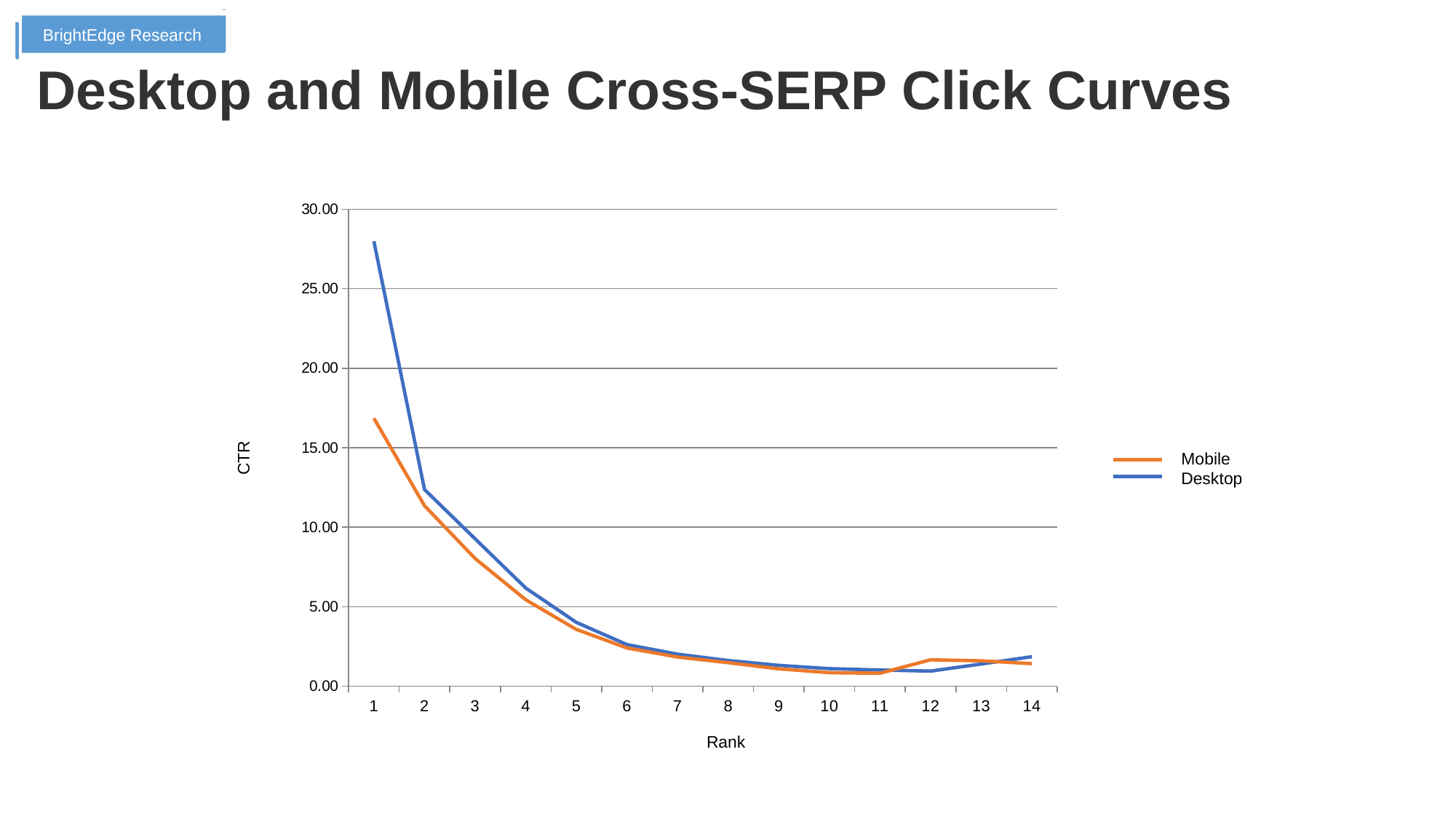
Is the Desktop CTR at rank 1 greater or less than 25.00? greater What kind of chart is shown on the slide? line chart Is the Mobile CTR at rank 1 greater or less than 15.00? greater How many series does the legend list? 2 Is the Desktop CTR at rank 5 greater or less than 5.00? less How many rank positions are plotted along the x axis? 14 Do the CTR values generally rise or fall as rank increases from 1 to 11? fall At rank 1, which series has the higher CTR, Mobile or Desktop? Desktop What is the label on the y axis of the chart? CTR At which rank does the Desktop series reach its highest CTR? 1